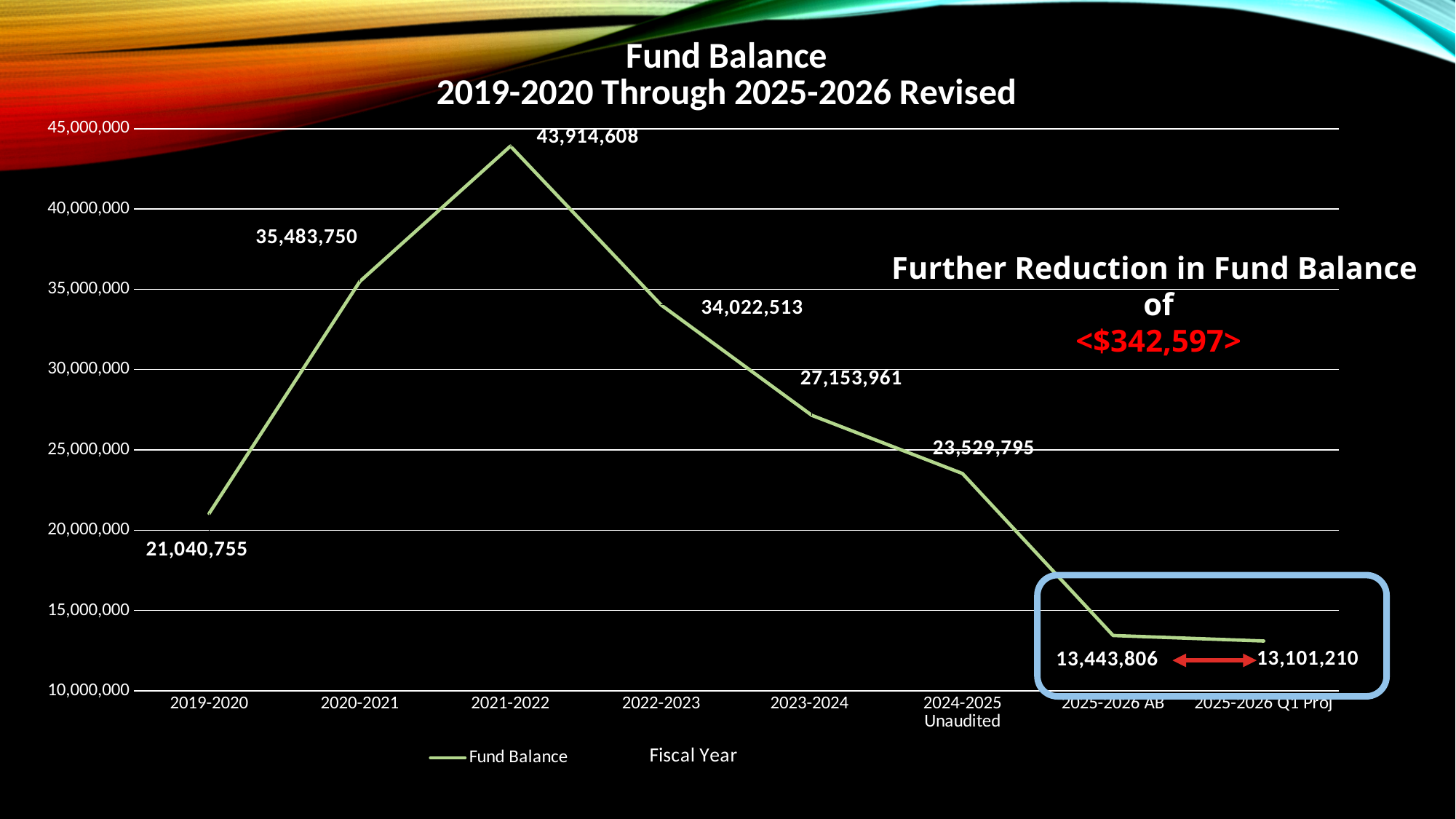
What is the fund balance for 2021-2022? 43,914,608 How many fiscal years are plotted on the chart? 8 What is the fund balance for 2025-2026 Q1 Proj? 13,101,210 Which fiscal year has the highest fund balance? 2021-2022 Which fiscal year has the lowest fund balance? 2025-2026 Q1 Proj What is the fund balance for 2024-2025 Unaudited? 23,529,795 Which is larger, the fund balance for 2020-2021 or 2022-2023? 2020-2021 What is the difference between the fund balance for 2021-2022 and 2019-2020? 22,873,853 Does the fund balance rise or fall from 2021-2022 to 2025-2026 Q1 Proj? Fall What kind of chart is shown on the slide? Line chart What is the difference between the fund balance for 2023-2024 and 2024-2025 Unaudited? 3,624,166 What is the fund balance for 2019-2020? 21,040,755